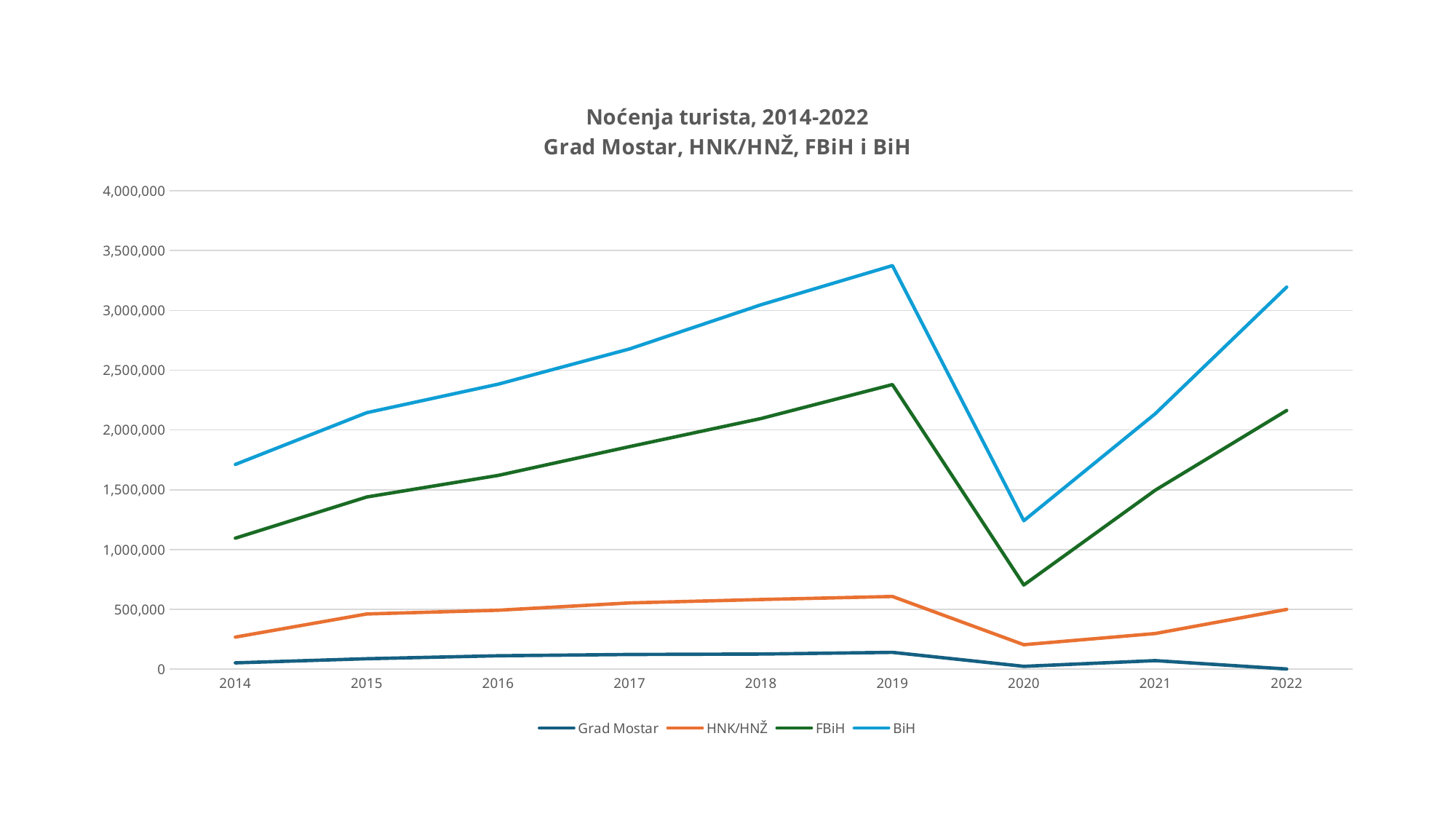
Do the BiH values rise or fall from 2014 to 2019? rise How many years are plotted along the x axis? 9 What kind of chart is shown on the slide? line chart Is the value for FBiH in 2020 greater or less than 1,000,000? less Is the value for BiH in 2014 greater or less than 2,000,000? less How many series does the legend list? 4 Which series has the higher value in 2022, BiH or FBiH? BiH In which year does the FBiH series reach its lowest value? 2020 In which year does the BiH series reach its lowest value? 2020 In which year does the BiH series reach its highest value? 2019 Is the value for HNK/HNŽ in 2019 greater or less than 500,000? greater